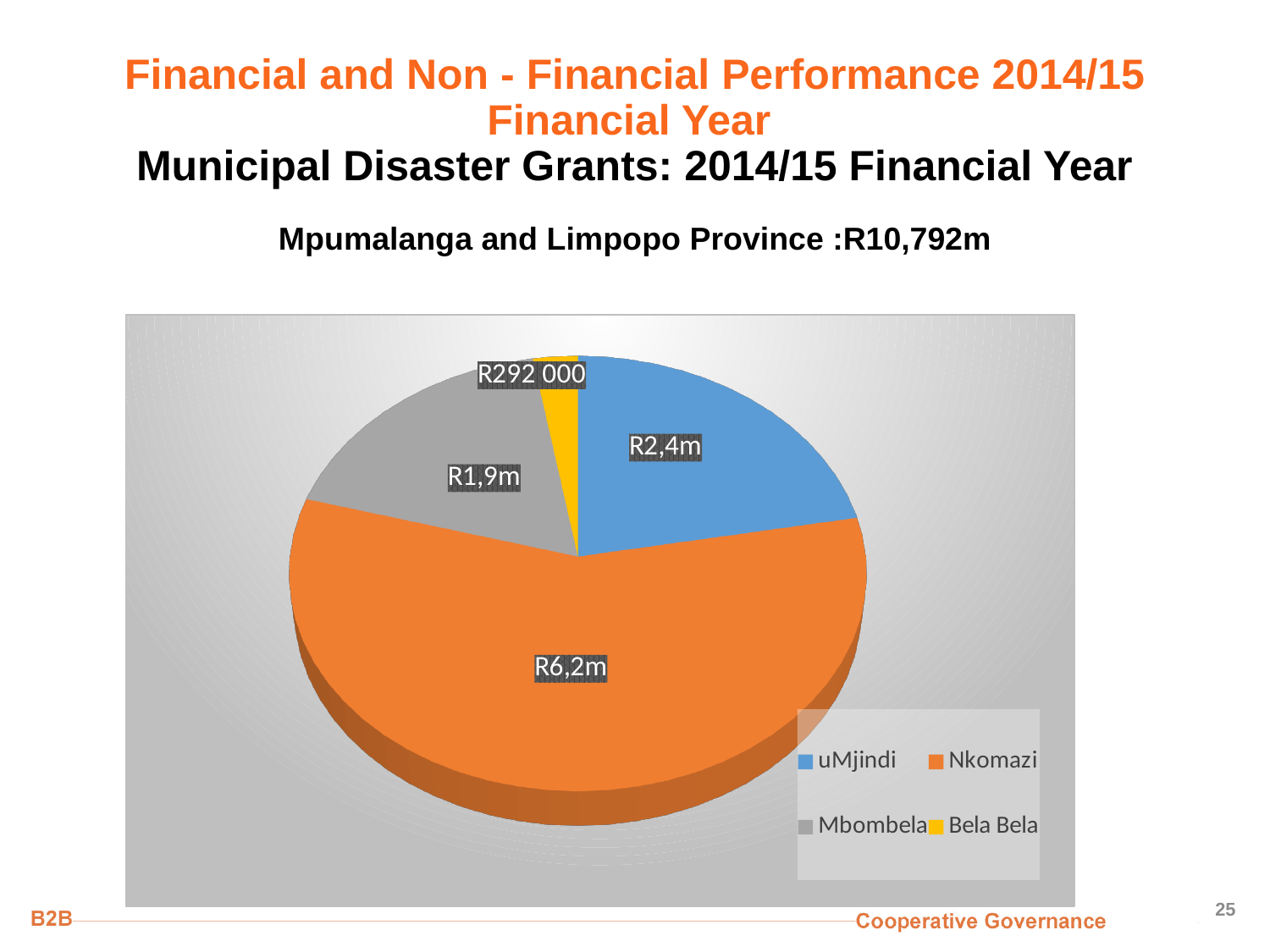
What is the difference between the values for Nkomazi and uMjindi? R3,8m What kind of chart is shown on the slide? Pie chart What value is shown for Nkomazi on the pie chart? R6,2m How many entries does the legend list? 4 How many municipalities are shown in the pie chart? 4 What value is shown for uMjindi on the pie chart? R2,4m What value is shown for Bela Bela on the pie chart? R292 000 Which municipality has the largest slice of the pie chart? Nkomazi Which is larger, the value for uMjindi or the value for Mbombela? uMjindi What colour is the slice for Mbombela? Grey Which municipality has the smallest slice of the pie chart? Bela Bela What value is shown for Mbombela on the pie chart? R1,9m